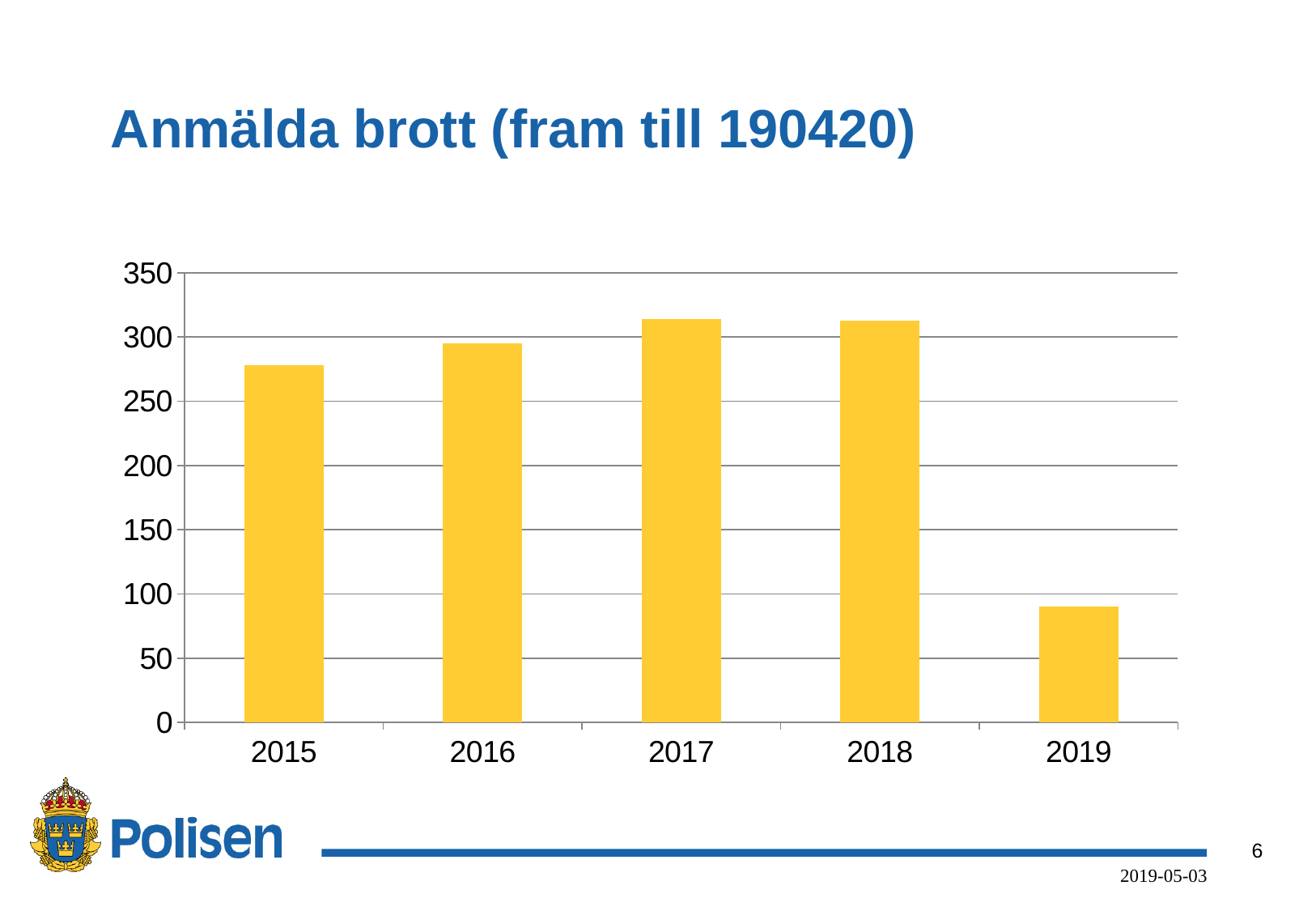
Which is larger, the value for 2018 or the value for 2019? 2018 Is the value for 2018 greater or less than 300? greater Is the value for 2017 greater or less than 300? greater Is the value for 2019 greater or less than 100? less What is the title of the slide containing the chart? Anmälda brott (fram till 190420) Which is larger, the value for 2015 or the value for 2016? 2016 What kind of chart is shown on the slide? bar chart Which year has the lowest value in the chart? 2019 What colour are the bars in the chart? yellow How many years are shown on the x axis of the chart? 5